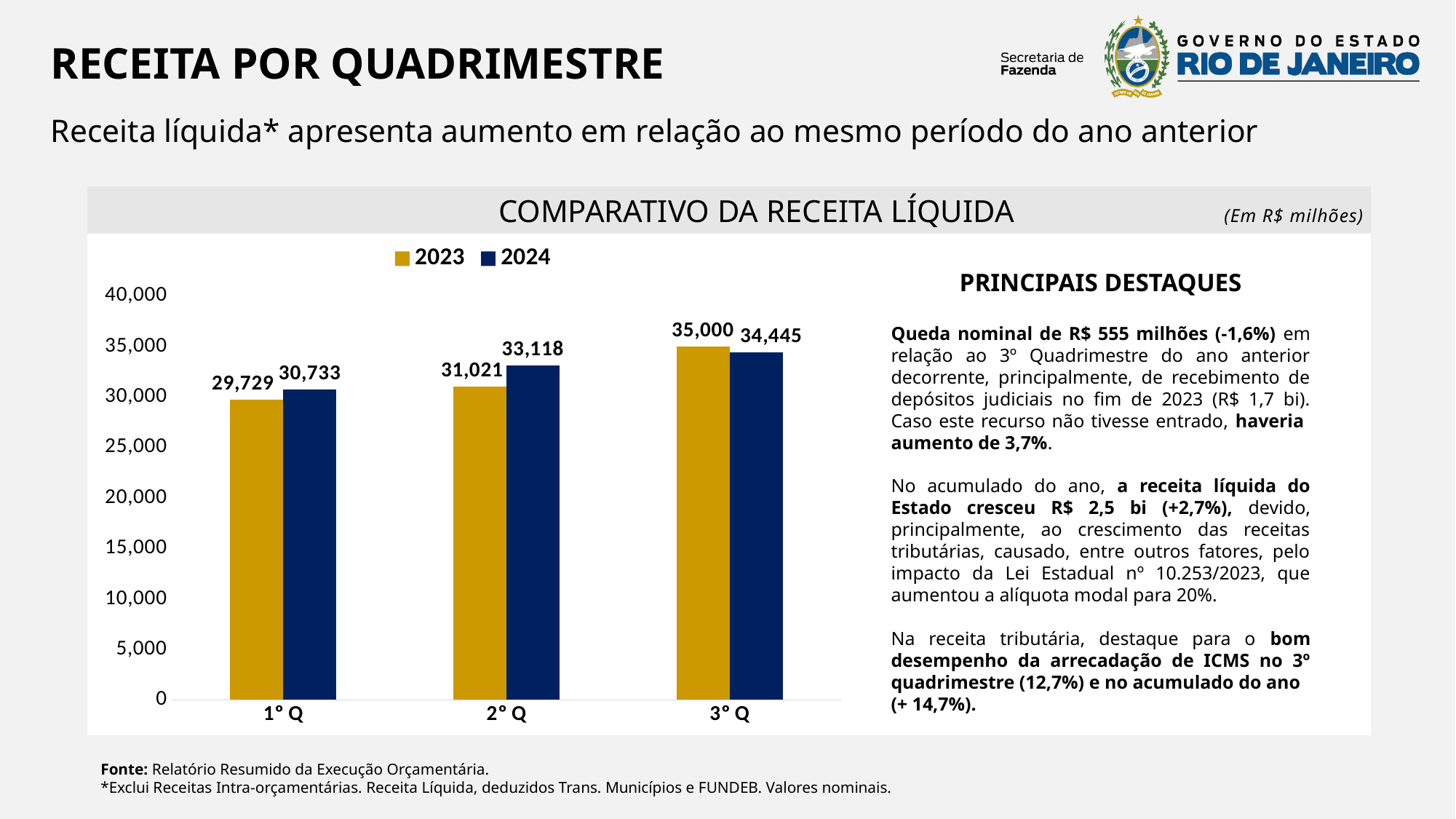
Is the 2023 value for 2° Q greater or less than 30,000? greater What kind of chart is shown? bar chart What is the difference between the 2024 and 2023 values for 2° Q? 2,097 For 3° Q, which series has the larger value, 2023 or 2024? 2023 How many quarters are shown on the x axis? 3 What is the 2023 value for 1° Q? 29,729 How many series does the legend list? 2 What is the 2024 value for 2° Q? 33,118 What is the 2024 value for 3° Q? 34,445 What is the title of the chart? COMPARATIVO DA RECEITA LÍQUIDA Which quarter has the highest 2023 value? 3° Q Which quarter has the lowest 2024 value? 1° Q